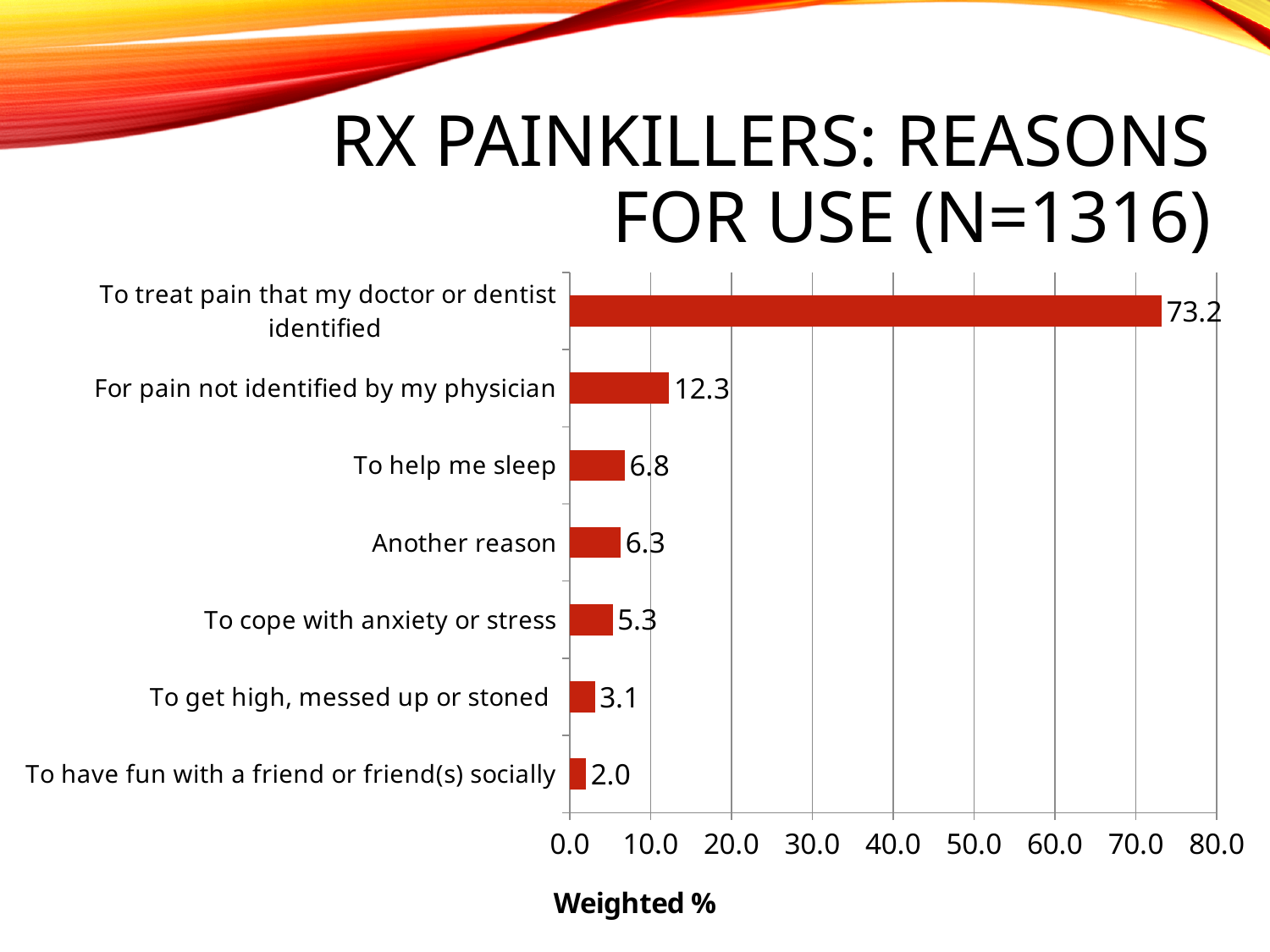
What is the difference in weighted % between "To help me sleep" and "Another reason"? 0.5 What is the weighted % for "To help me sleep"? 6.8 What is the weighted % for "To get high, messed up or stoned"? 3.1 What is the difference in weighted % between "To treat pain that my doctor or dentist identified" and "For pain not identified by my physician"? 60.9 Which reason has the highest weighted %? To treat pain that my doctor or dentist identified Is the value for "To treat pain that my doctor or dentist identified" greater or less than 70.0? greater What kind of chart is shown on the slide? Bar chart Which has a larger weighted %: "To cope with anxiety or stress" or "To get high, messed up or stoned"? To cope with anxiety or stress Which reason has the lowest weighted %? To have fun with a friend or friend(s) socially What is the label of the horizontal axis? Weighted % What is the weighted % for "For pain not identified by my physician"? 12.3 How many reasons are shown in the chart? 7